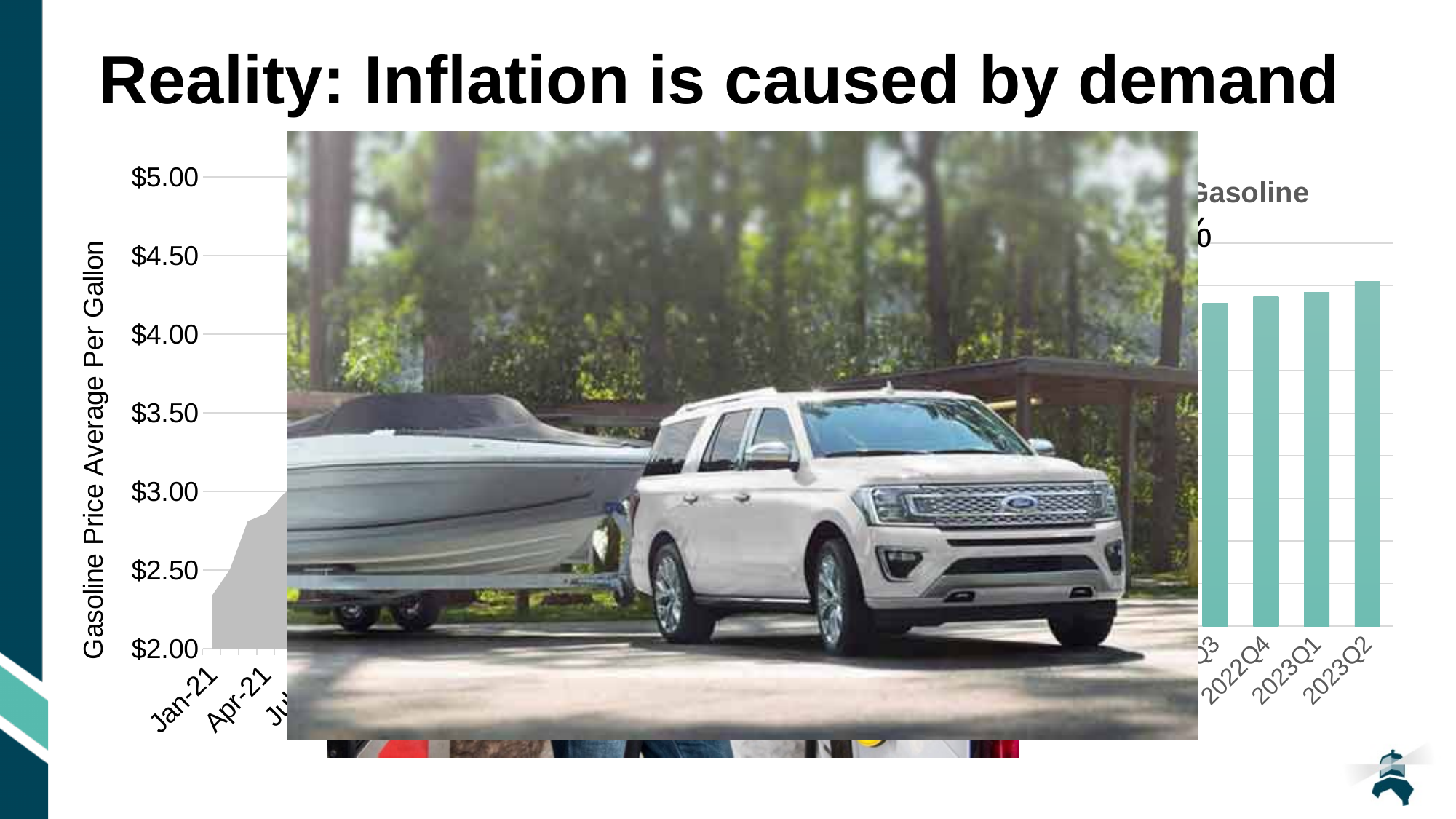
Among the teal bars for 2022Q4, 2023Q1 and 2023Q2, which is the tallest? 2023Q2 What is the label on the left vertical axis of the chart? Gasoline Price Average Per Gallon What is the lowest tick value shown on the left vertical axis of the chart? $2.00 Which teal bar is taller, 2022Q4 or 2023Q2? 2023Q2 What kind of chart is the teal series on the right side of the chart drawn as? bar chart Among the teal bars for 2022Q4, 2023Q1 and 2023Q2, which is the shortest? 2022Q4 Do the teal bars rise or fall from 2022Q4 to 2023Q2? rise